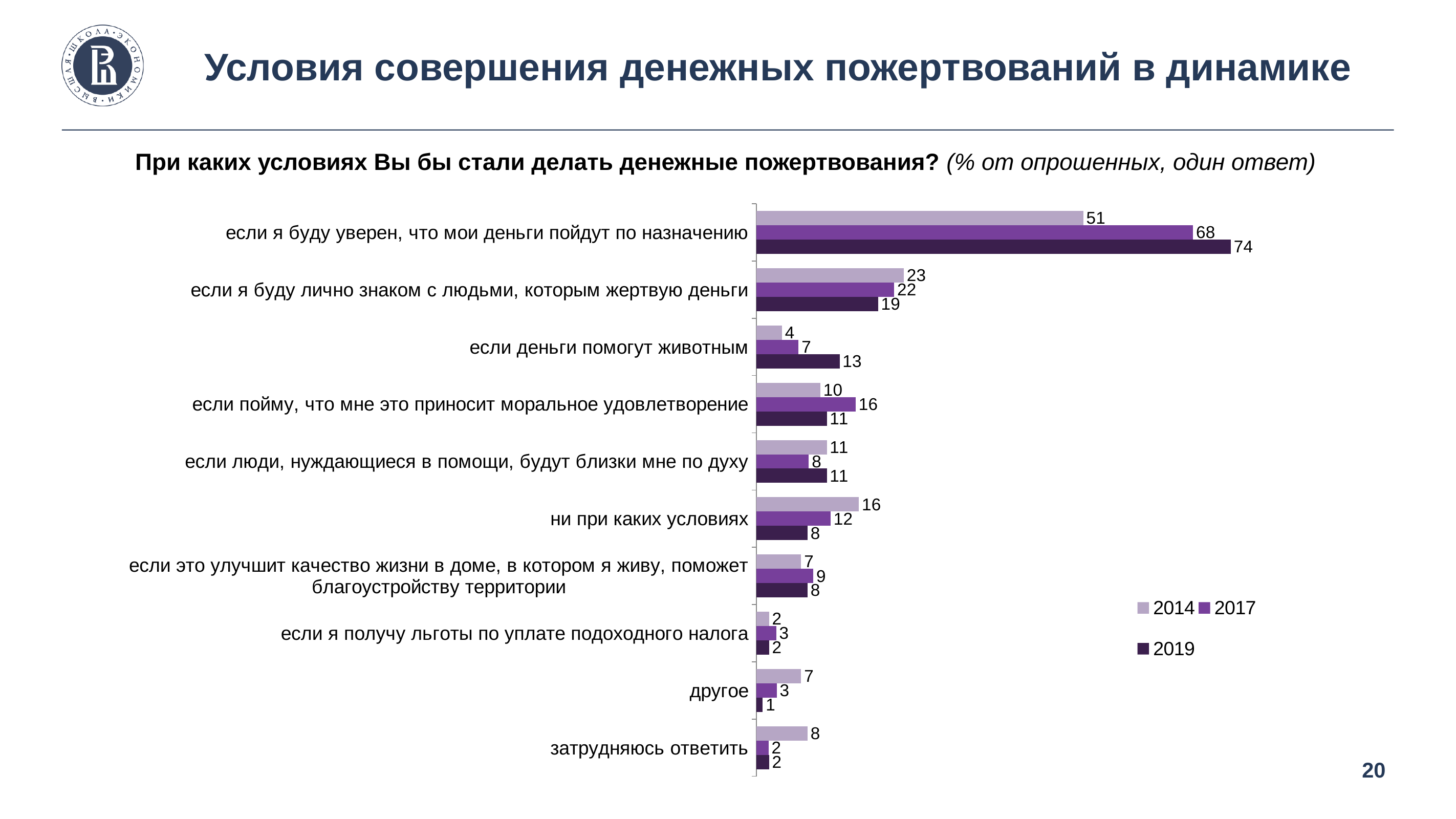
Which category has the highest 2017 value? если я буду уверен, что мои деньги пойдут по назначению What is the 2014 value for "если я буду лично знаком с людьми, которым жертвую деньги"? 23 What kind of chart is shown on the slide? bar chart How many series does the legend list? 3 What is the 2019 value for "если я буду уверен, что мои деньги пойдут по назначению"? 74 For "ни при каких условиях", which is larger: the 2014 value or the 2019 value? 2014 How many categories are shown on the chart? 10 What is the 2019 value for "если деньги помогут животным"? 13 Which category has the lowest 2019 value? другое What is the difference between the 2019 and 2014 values for "если я буду уверен, что мои деньги пойдут по назначению"? 23 Which years are listed in the chart legend? 2014, 2017, 2019 What is the 2017 value for "если пойму, что мне это приносит моральное удовлетворение"? 16